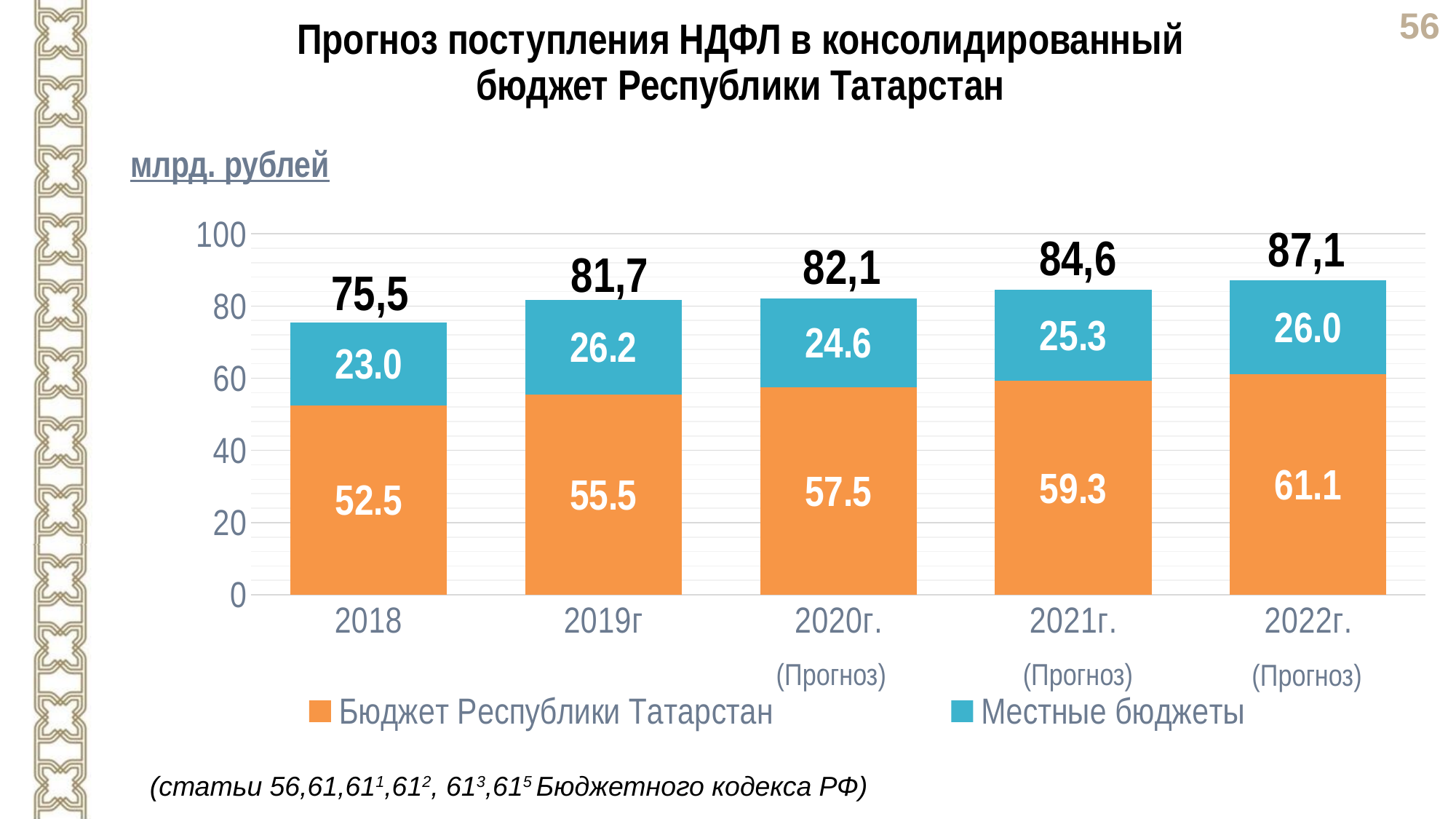
What is the total shown above the stacked bar for 2020г. (Прогноз)? 82,1 What is the value for Бюджет Республики Татарстан in 2022г. (Прогноз)? 61.1 What kind of chart is shown on the slide? Stacked bar chart How many years are shown on the x axis? 5 What is the value for Бюджет Республики Татарстан in 2018? 52.5 What is the difference between the Бюджет Республики Татарстан values for 2022г. (Прогноз) and 2018? 8.6 Which year has the highest value for Бюджет Республики Татарстан? 2022г. (Прогноз) How many series does the legend list? 2 What is the value for Местные бюджеты in 2019г? 26.2 Do the total values rise or fall from 2018 to 2022г. (Прогноз)? Rise Which year has the lowest value for Местные бюджеты? 2018 Which is larger: Местные бюджеты in 2019г or Местные бюджеты in 2021г. (Прогноз)? 2019г